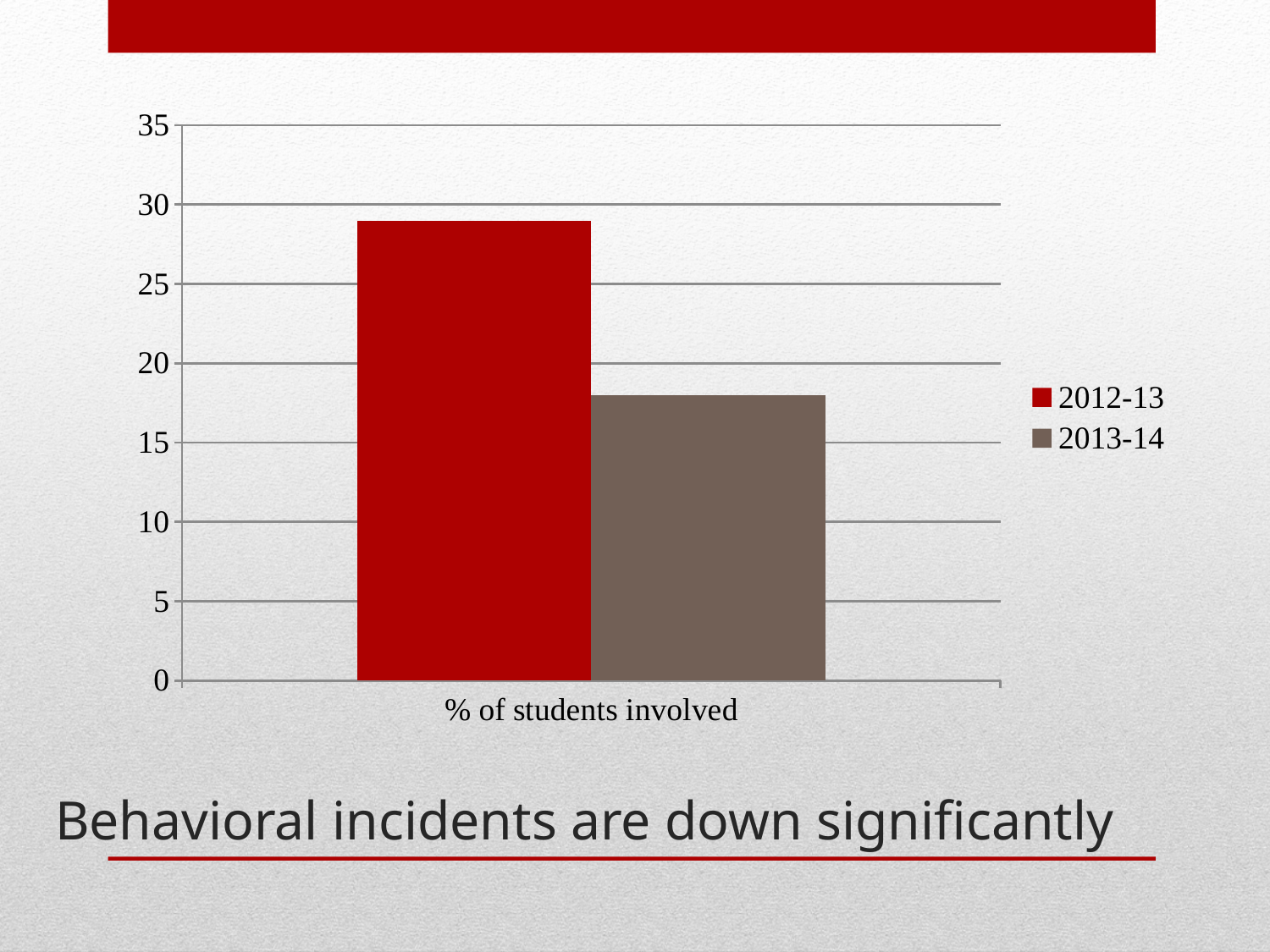
Which series has the lowest value for % of students involved? 2013-14 What is the label of the category on the x axis? % of students involved Which series has the highest value for % of students involved? 2012-13 Is the value for 2013-14 greater or less than 20? less How many categories are shown on the x axis? 1 Which series is shown in red in the legend? 2012-13 How many series does the legend list? 2 Is the value for 2012-13 greater or less than 30? less What kind of chart is shown on the slide? bar chart Is the value for 2012-13 greater or less than 25? greater Which series has the taller bar, 2012-13 or 2013-14? 2012-13